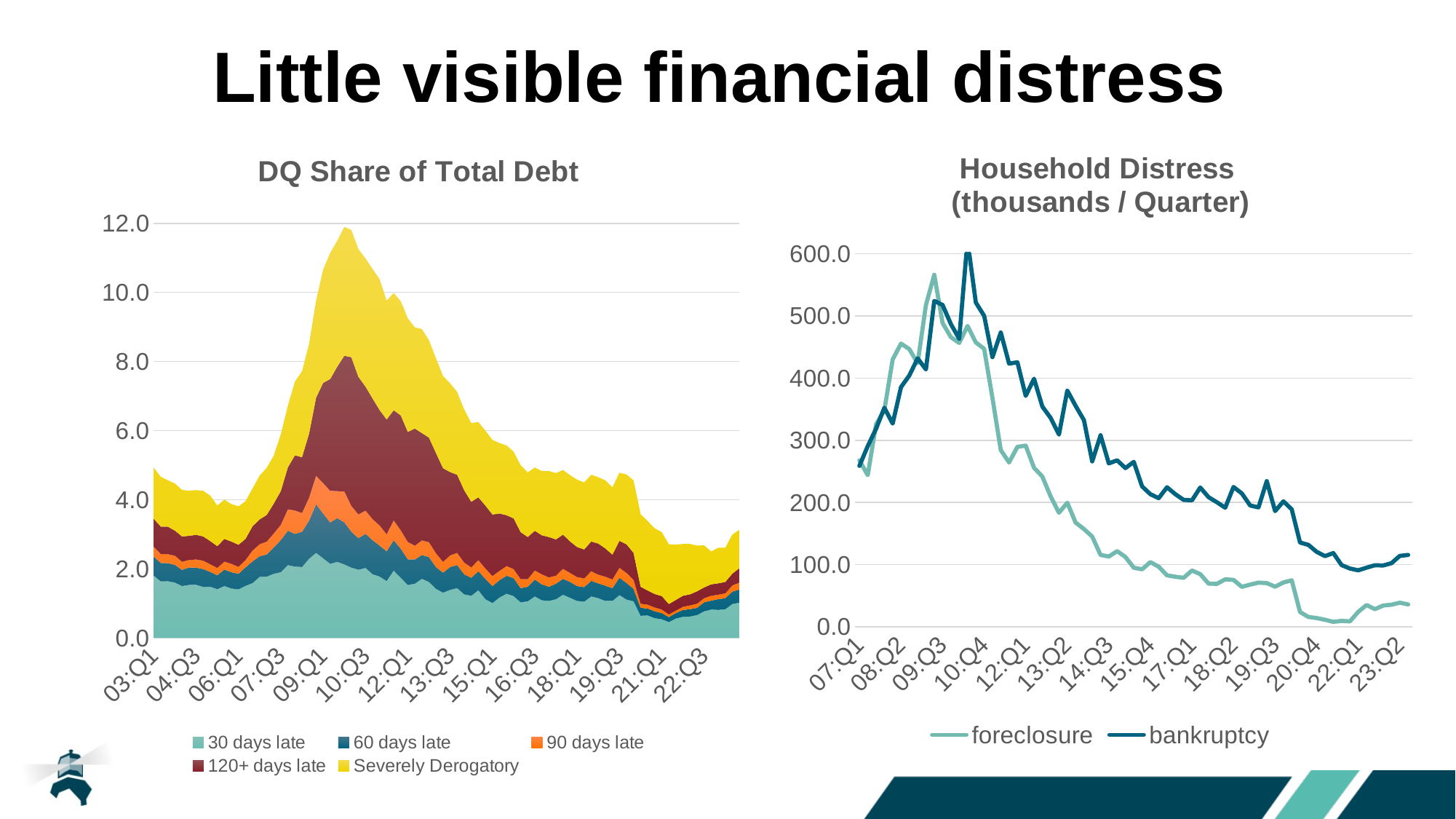
In the "DQ Share of Total Debt" chart, is the total delinquent share at 21:Q1 greater or less than 4.0? less In the "DQ Share of Total Debt" chart, does the total delinquent share rise or fall between 10:Q3 and 21:Q1? fall In the "Household Distress (thousands / Quarter)" chart, at 14:Q3 which series is larger, foreclosure or bankruptcy? bankruptcy In the "DQ Share of Total Debt" chart, is the total delinquent share at its peak around 09:Q1–10:Q3 greater or less than 10.0? greater In the "Household Distress (thousands / Quarter)" chart, which series reaches the highest value? bankruptcy In the "DQ Share of Total Debt" chart, which series is shown in yellow? Severely Derogatory How many series does the legend of the "Household Distress (thousands / Quarter)" chart list? 2 In the "Household Distress (thousands / Quarter)" chart, is the foreclosure value at 23:Q2 greater or less than 100.0? less How many series does the legend of the "DQ Share of Total Debt" chart list? 5 In the "Household Distress (thousands / Quarter)" chart, does the bankruptcy series rise or fall between 10:Q4 and 22:Q1? fall What kind of chart is the "DQ Share of Total Debt" chart? stacked area chart What kind of chart is the "Household Distress (thousands / Quarter)" chart? line chart